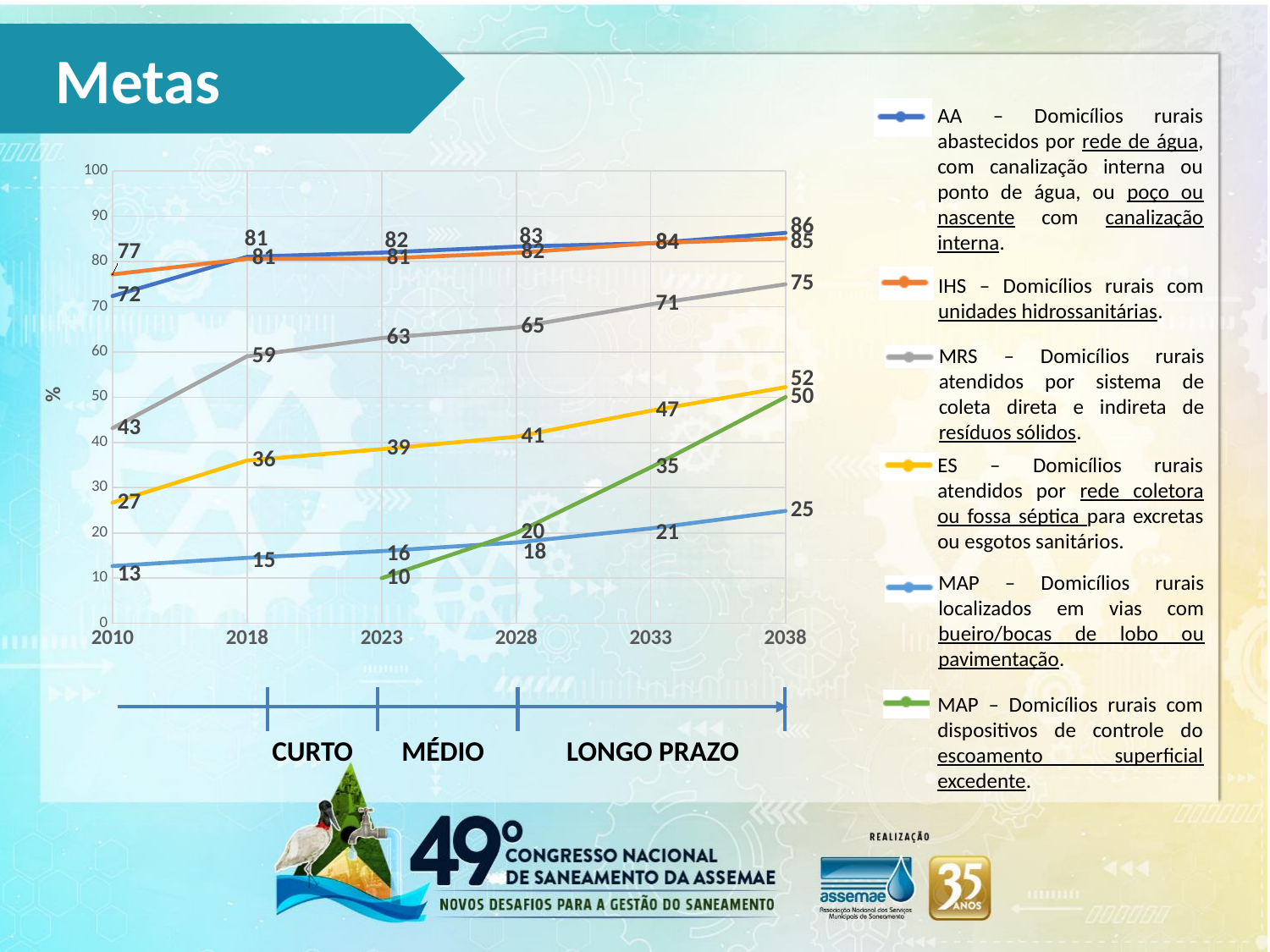
What kind of chart is shown on the slide? line chart What is the value of the AA series in 2038? 86 What is the value of the IHS series in 2010? 77 How many series does the legend list? 6 Which series has the lowest value in 2010? MAP (light blue, bueiro/bocas de lobo ou pavimentação) How many years are shown on the x axis of the chart? 6 What is the value of the green MAP series (dispositivos de controle do escoamento superficial excedente) in 2023? 10 What is the value of the MRS series in 2038? 75 What is the value of the ES series in 2010? 27 Which series has the highest value in 2038? AA By how much does the MRS series increase from 2010 to 2038? 32 Does the MRS series rise or fall from 2010 to 2038? rise